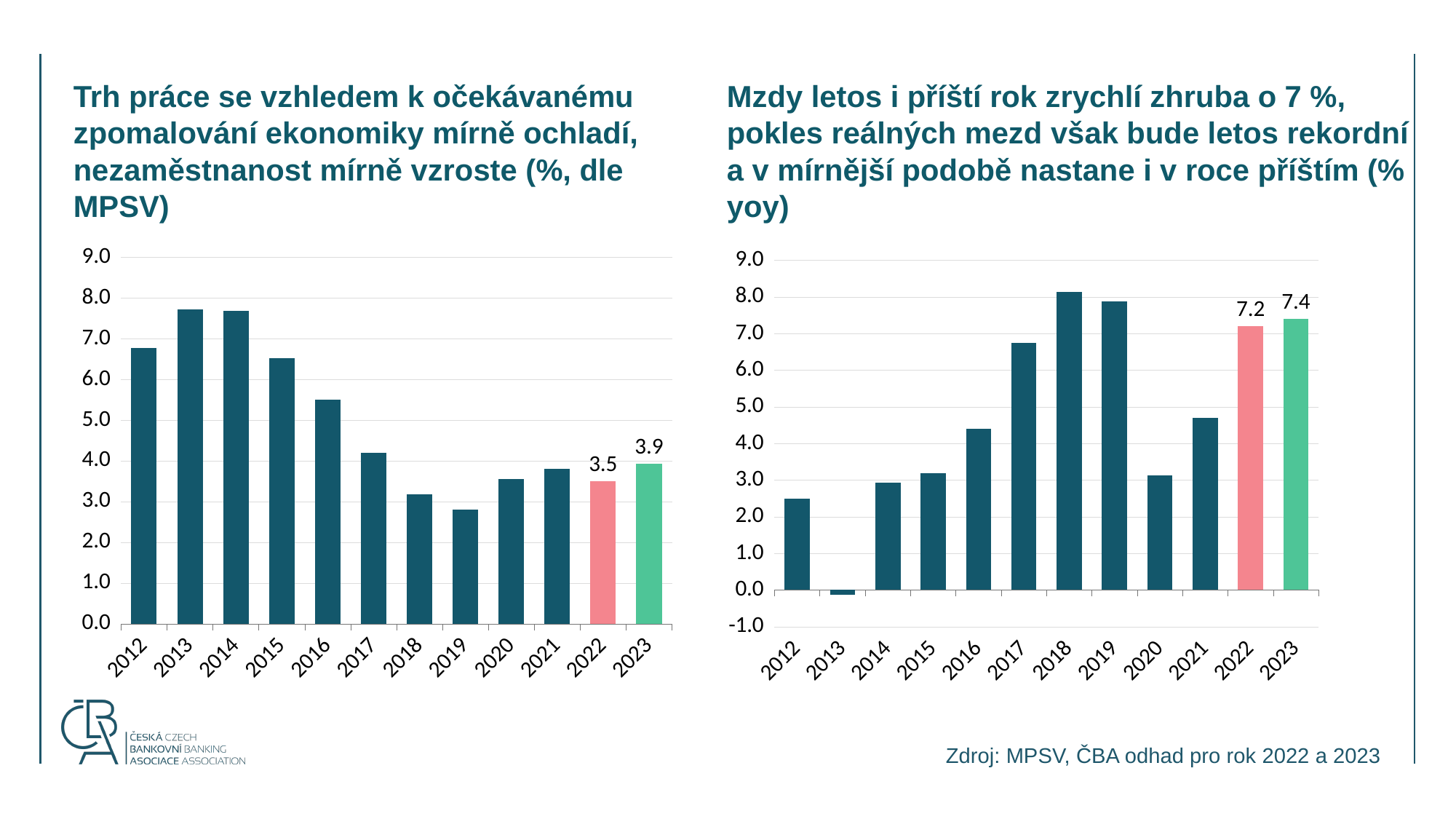
In the left chart (unemployment, dle MPSV), what is the value for 2022? 3.5 In the right chart (wages, % yoy), what is the value for 2023? 7.4 In the right chart (wages, % yoy), is the value for 2020 greater or less than 4.0? less In the right chart (wages, % yoy), what is the difference between the 2023 and 2022 values? 0.2 In the left chart (unemployment, dle MPSV), is the value for 2016 greater or less than 5.0? greater How many years are shown on the x axis of the left chart (unemployment, dle MPSV)? 12 In the right chart (wages, % yoy), which year has the lowest value? 2013 What kind of chart is the right chart (wages, % yoy)? bar chart In the left chart (unemployment, dle MPSV), what is the difference between the 2023 and 2022 values? 0.4 In the left chart (unemployment, dle MPSV), what is the value for 2023? 3.9 In the right chart (wages, % yoy), what is the value for 2022? 7.2 In the left chart (unemployment, dle MPSV), which year has the lowest value? 2019